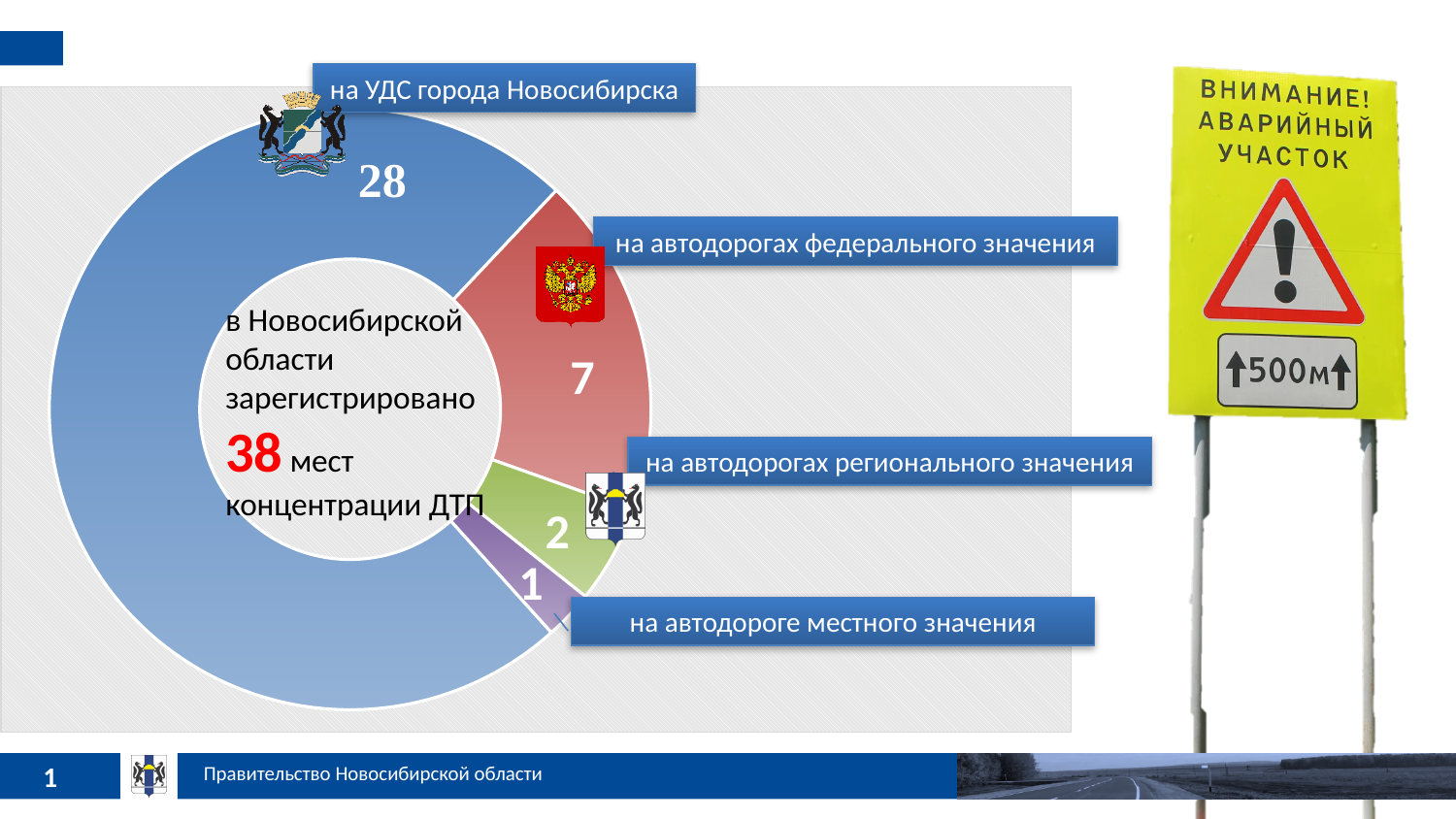
How many segments does the donut chart have? 4 What is the difference between the values for "на УДС города Новосибирска" and "на автодорогах федерального значения"? 21 What is the value for the segment labelled "на УДС города Новосибирска"? 28 What is the value for the segment labelled "на автодороге местного значения"? 1 What kind of chart is shown on the slide? Donut (pie) chart What is the total number of accident concentration sites registered in Novosibirsk region, as stated in the centre of the chart? 38 Which is larger: the value for "на автодорогах федерального значения" or for "на автодорогах регионального значения"? на автодорогах федерального значения What is the value for the segment labelled "на автодорогах федерального значения"? 7 What colour is the segment representing "на автодорогах федерального значения"? Red Which segment of the donut chart has the lowest value? на автодороге местного значения Which segment of the donut chart has the highest value? на УДС города Новосибирска What is the value for the segment labelled "на автодорогах регионального значения"? 2